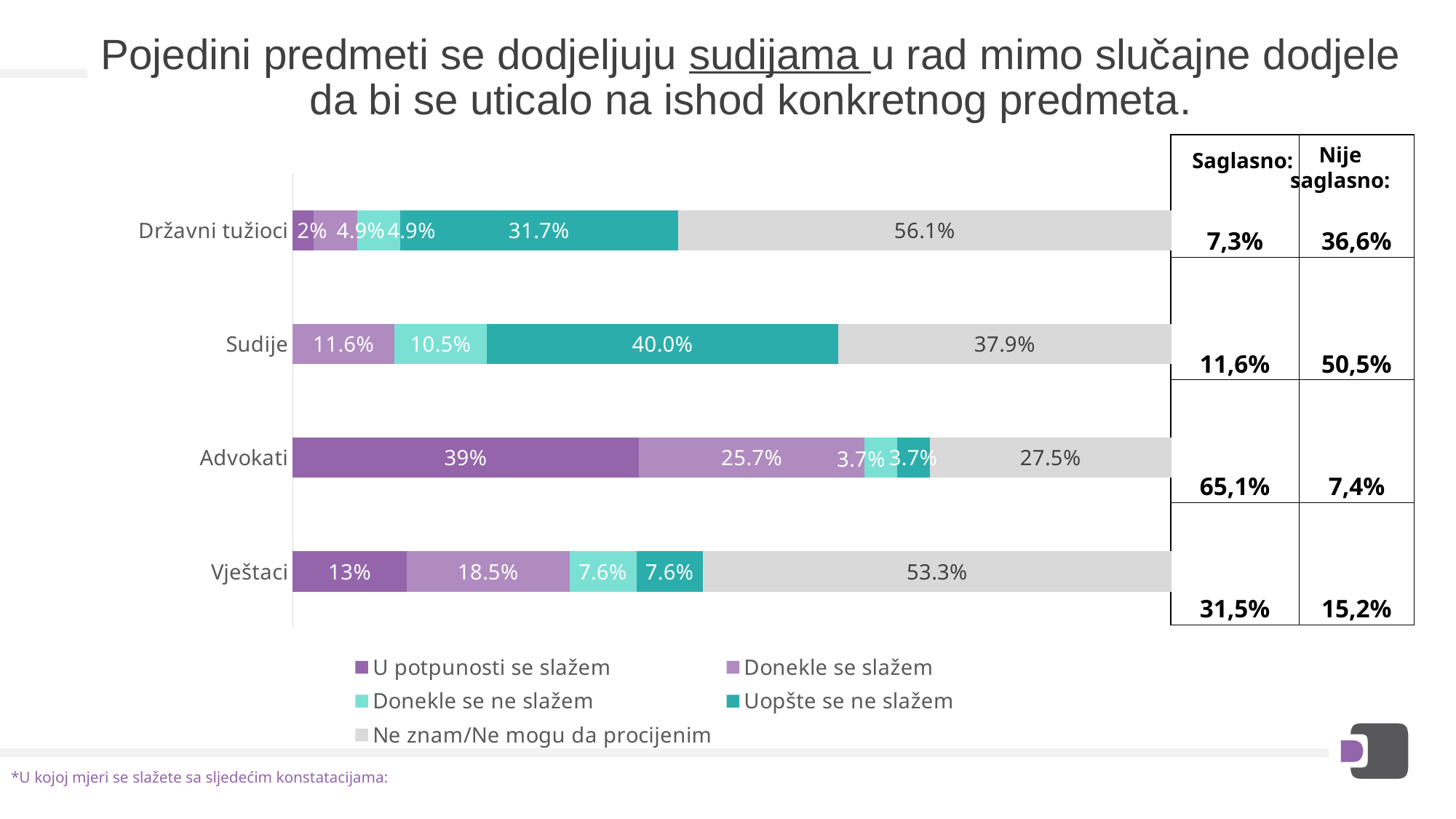
Which category has the lowest value for "Ne znam/Ne mogu da procijenim"? Advokati What is the value of "U potpunosti se slažem" for Advokati? 39% What colour represents "Ne znam/Ne mogu da procijenim" in the legend? Grey How many series does the legend list? 5 What is the value of "Uopšte se ne slažem" for Sudije? 40.0% Which has a larger "Uopšte se ne slažem" value, Sudije or Državni tužioci? Sudije Which category has the highest value for "U potpunosti se slažem"? Advokati What kind of chart is shown on the slide? Stacked bar chart What is the value of "Ne znam/Ne mogu da procijenim" for Državni tužioci? 56.1% How many categories are shown on the chart? 4 What is the difference between the "Ne znam/Ne mogu da procijenim" values for Državni tužioci and Vještaci? 2.8 percentage points What is the value of "Donekle se slažem" for Vještaci? 18.5%